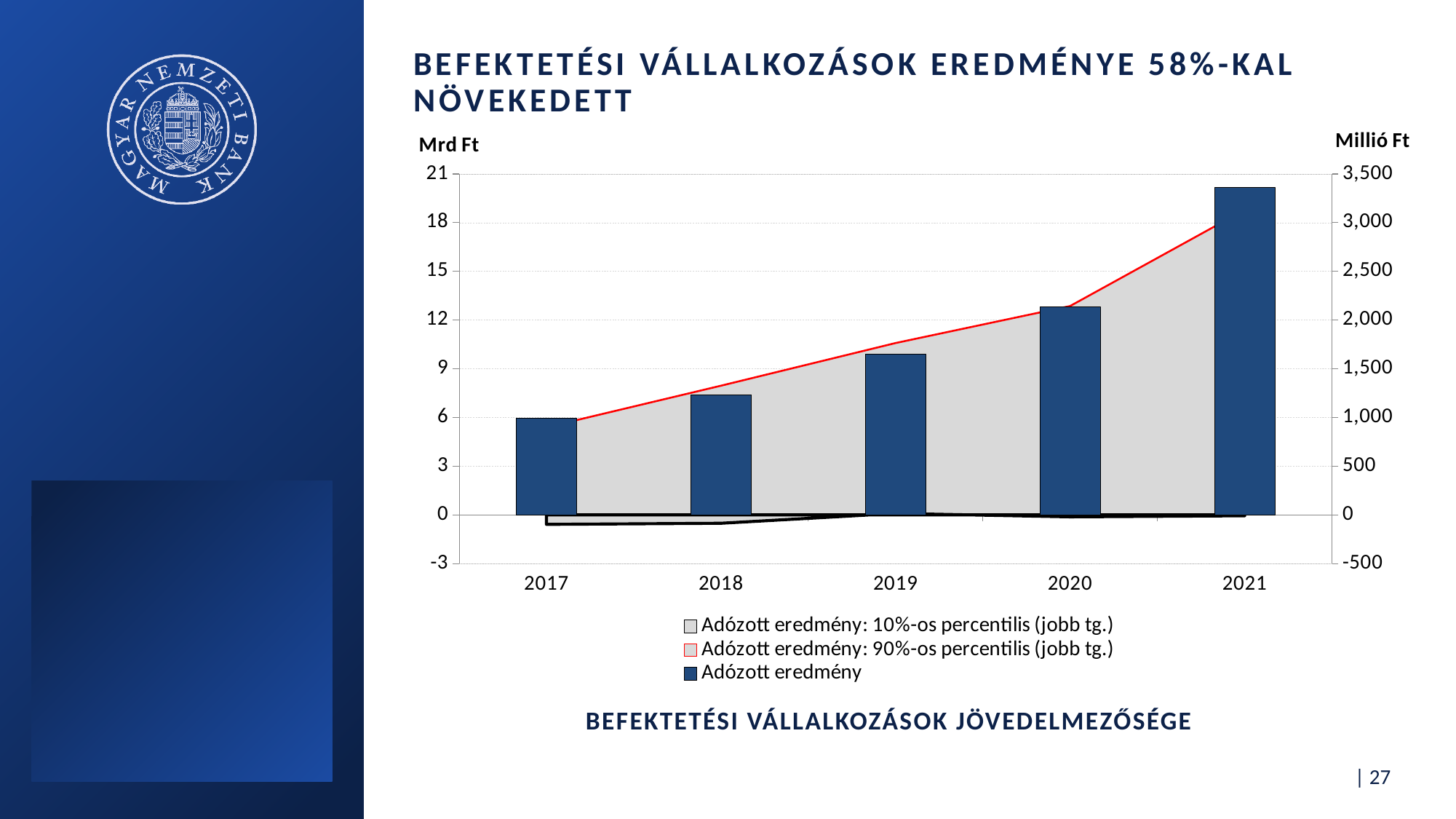
What kind of chart is used to show the Adózott eredmény series? bar chart In which year is the Adózott eredmény bar the highest? 2021 In which year is the Adózott eredmény bar the lowest? 2017 How many years are shown on the x axis of the chart? 5 Is the Adózott eredmény value for 2021 greater or less than 18 Mrd Ft? greater Do the Adózott eredmény bars rise or fall from 2017 to 2021? rise Which series is drawn as the red line in the chart? Adózott eredmény: 90%-os percentilis (jobb tg.) How many series does the chart legend list? 3 Is the Adózott eredmény value for 2019 greater or less than 12 Mrd Ft? less Is the Adózott eredmény value for 2017 greater or less than 9 Mrd Ft? less Which year has the larger Adózott eredmény bar, 2019 or 2020? 2020 What unit is shown on the left vertical axis of the chart? Mrd Ft